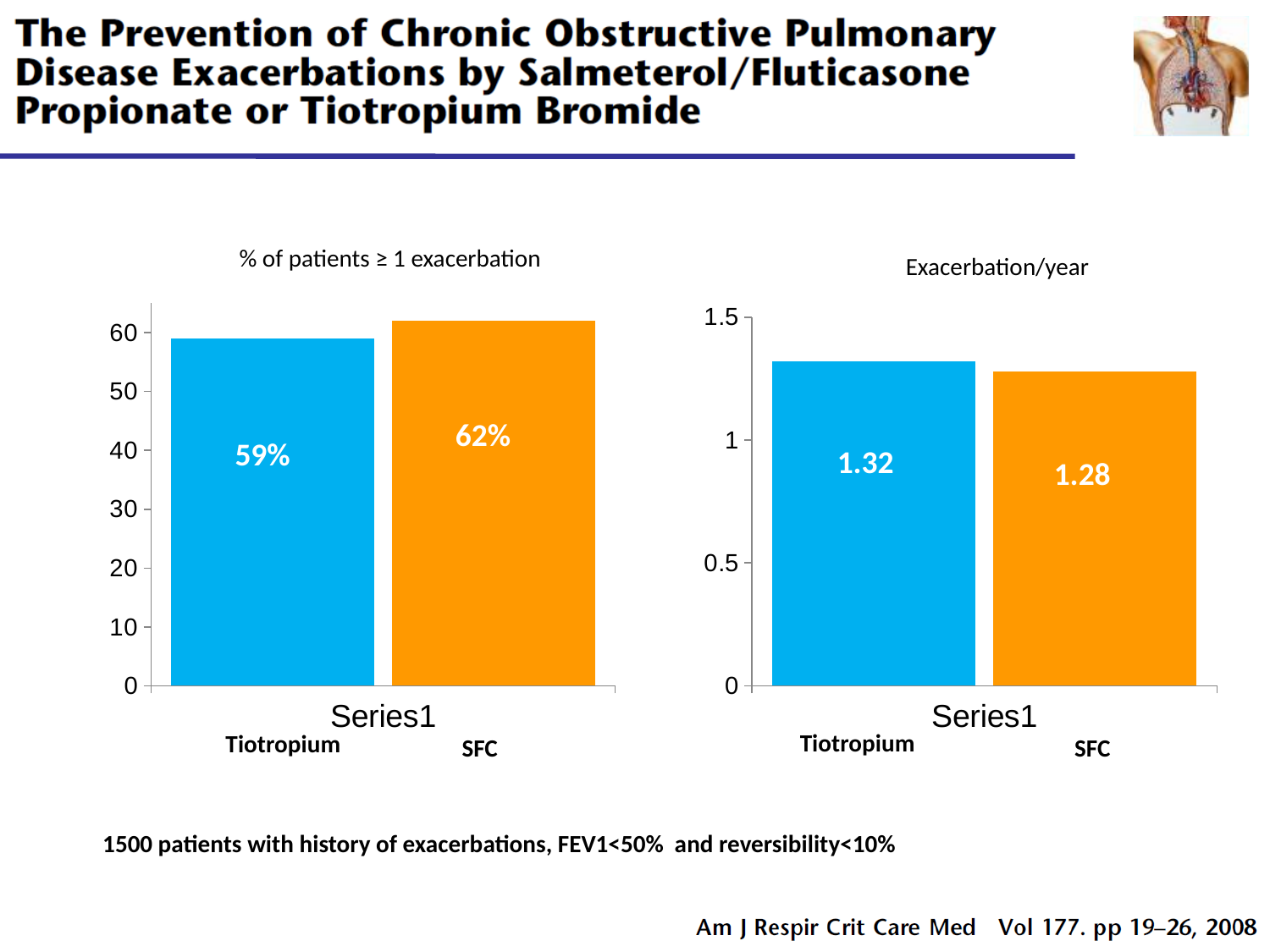
In the 'Exacerbation/year' chart, what is the value for SFC? 1.28 In the '% of patients ≥ 1 exacerbation' chart, what is the value for SFC? 62% In the 'Exacerbation/year' chart, which group has the lower value? SFC In the 'Exacerbation/year' chart, is the value for Tiotropium greater or less than 1? greater In the '% of patients ≥ 1 exacerbation' chart, what is the value for Tiotropium? 59% What type of chart is the 'Exacerbation/year' chart? bar chart In the 'Exacerbation/year' chart, what colour is the SFC bar? orange In the '% of patients ≥ 1 exacerbation' chart, which group has the higher value? SFC In the 'Exacerbation/year' chart, what is the difference between the Tiotropium and SFC values? 0.04 In the '% of patients ≥ 1 exacerbation' chart, what is the difference between the SFC and Tiotropium values? 3% How many bars are shown in the '% of patients ≥ 1 exacerbation' chart? 2 In the 'Exacerbation/year' chart, what is the value for Tiotropium? 1.32